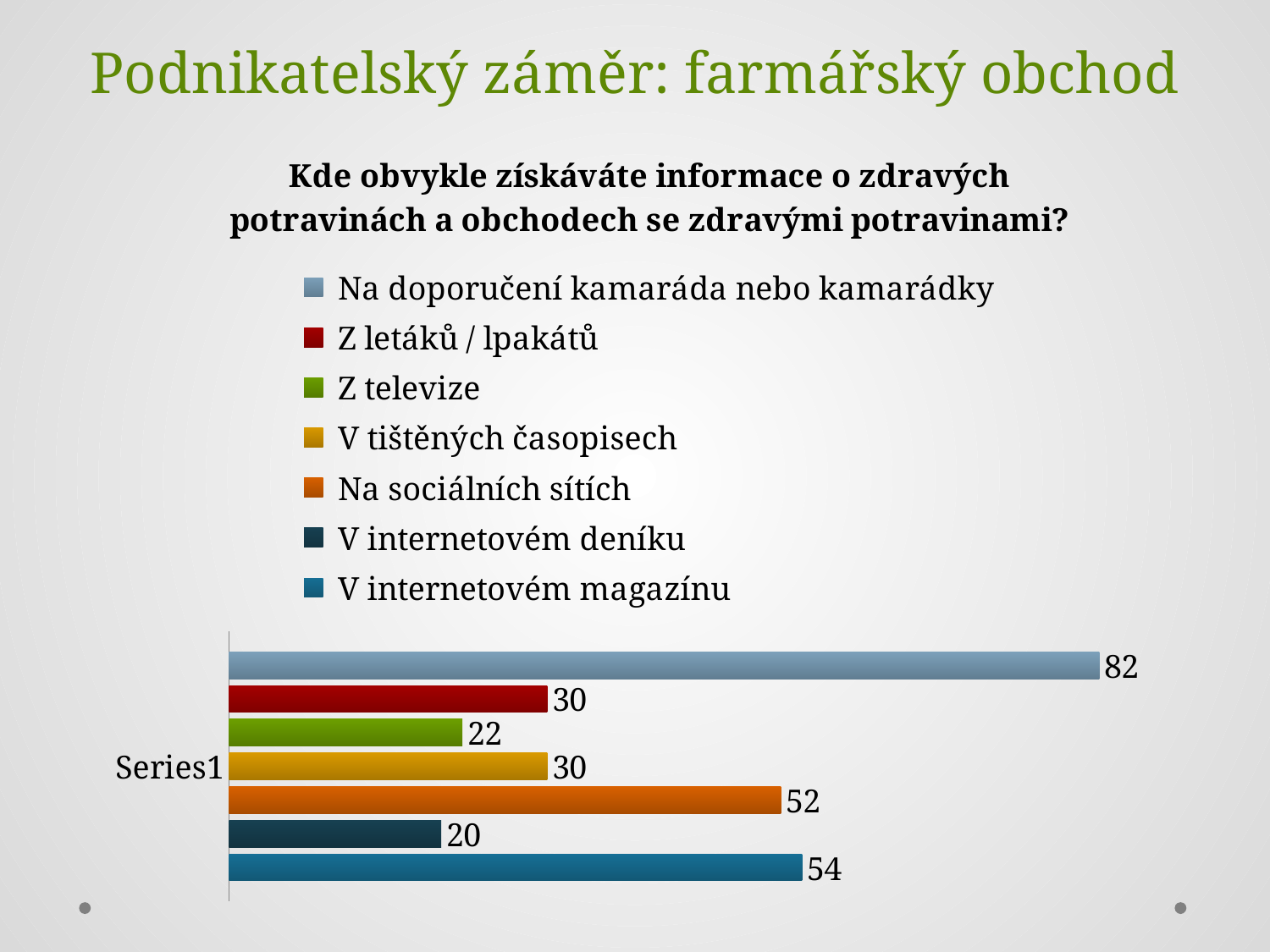
What is the difference between the values for "Z letáků / lpakátů" and "V internetovém deníku"? 10 Which information source has the highest value? Na doporučení kamaráda nebo kamarádky What value is shown for "Z televize"? 22 What is the difference between the values for "Na doporučení kamaráda nebo kamarádky" and "V internetovém magazínu"? 28 What kind of chart is shown on the slide? Bar chart How many series does the legend list? 7 What value is shown for "Na sociálních sítích"? 52 What is the title of the chart? Kde obvykle získáváte informace o zdravých potravinách a obchodech se zdravými potravinami? What value is shown for "V internetovém magazínu"? 54 Which is larger, the value for "Na sociálních sítích" or the value for "V internetovém magazínu"? V internetovém magazínu What value is shown for "Na doporučení kamaráda nebo kamarádky"? 82 Which information source has the lowest value? V internetovém deníku